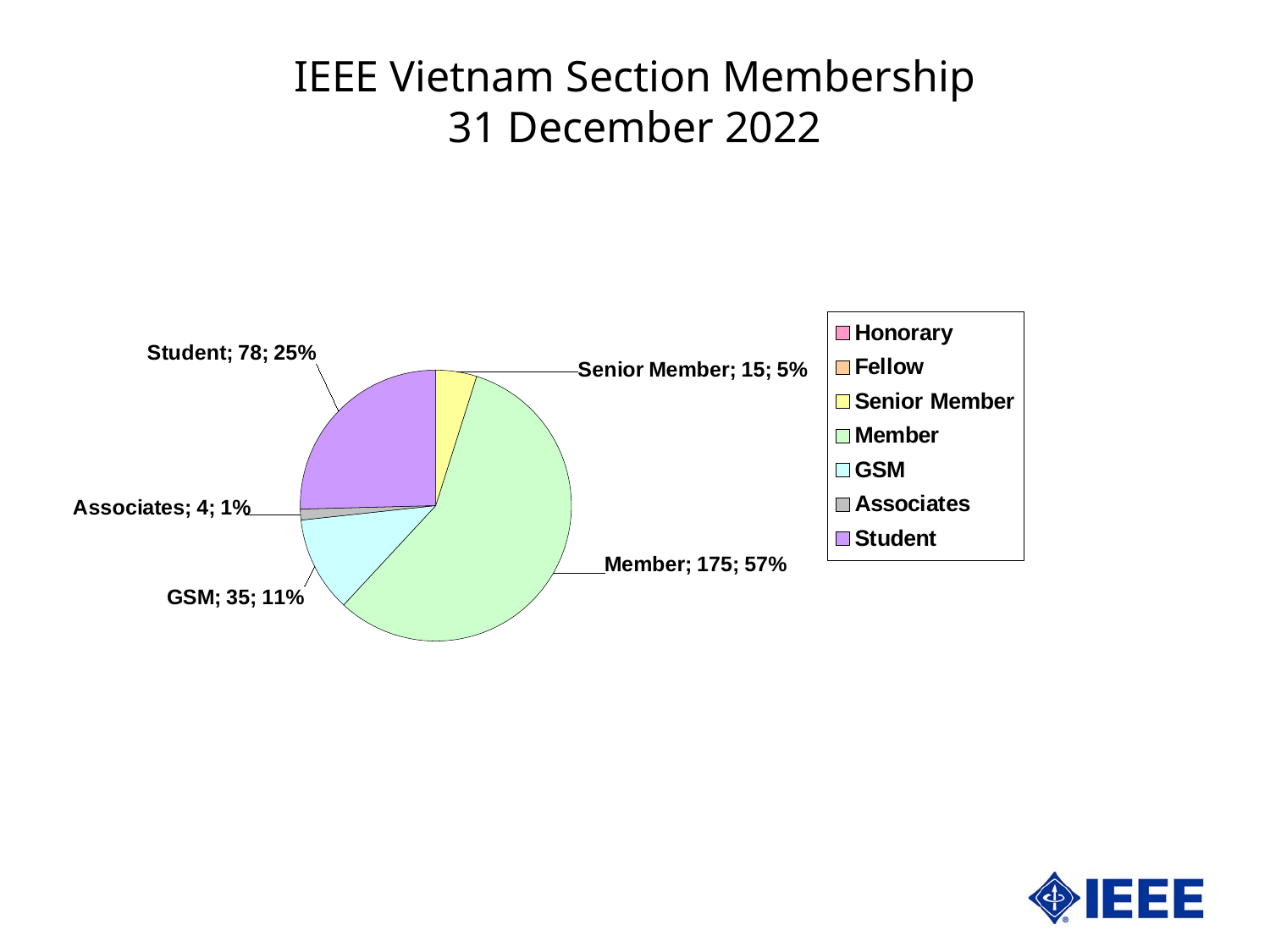
Which is larger, the GSM count or the Senior Member count? GSM How many entries does the legend list? 7 Which category has the largest slice of the pie? Member How many members are in the Member category? 175 What share of the pie does the Student slice represent? 25% What is the difference between the Member count and the Student count? 97 How many members are in the GSM category? 35 What kind of chart is shown on the slide? pie chart What is the value for Associates? 4 What colour is the Student slice? purple Which labelled slice has the smallest value? Associates What percentage of membership is Senior Member? 5%